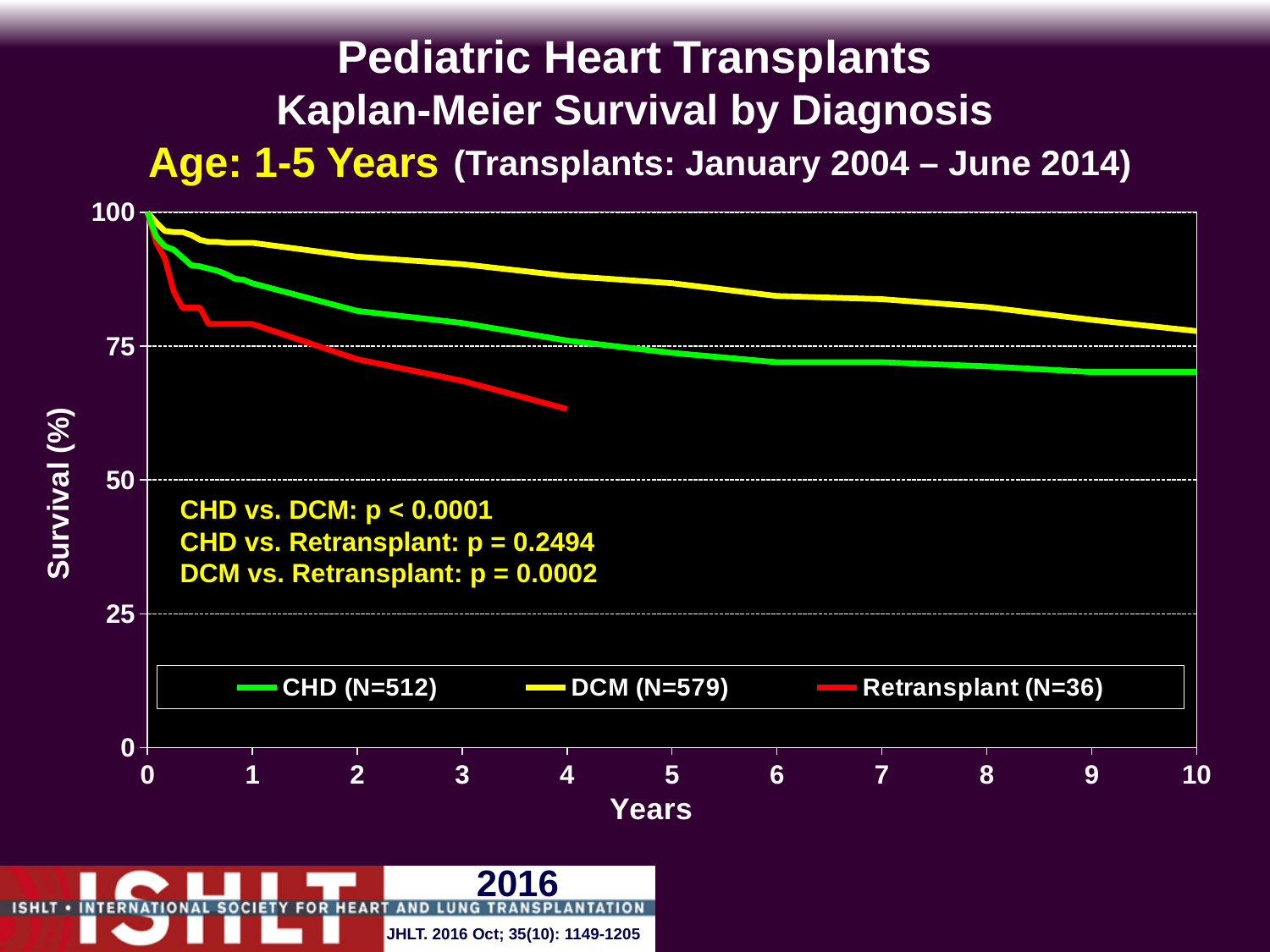
How many series does the legend list? 3 Which series has the highest survival at 10 years? DCM At 5 years, which series has higher survival, CHD or DCM? DCM Which series has the lowest survival at 4 years? Retransplant Is the survival for CHD at 2 years greater or less than 75? greater Is the survival for Retransplant at 4 years greater or less than 75? less What kind of chart is shown on the slide? line chart Do the survival curves rise or fall as years increase? fall What is the N for the DCM group shown in the legend? 579 Is the survival for DCM at 5 years greater or less than 75? greater What p-value is given for CHD vs. DCM? p < 0.0001